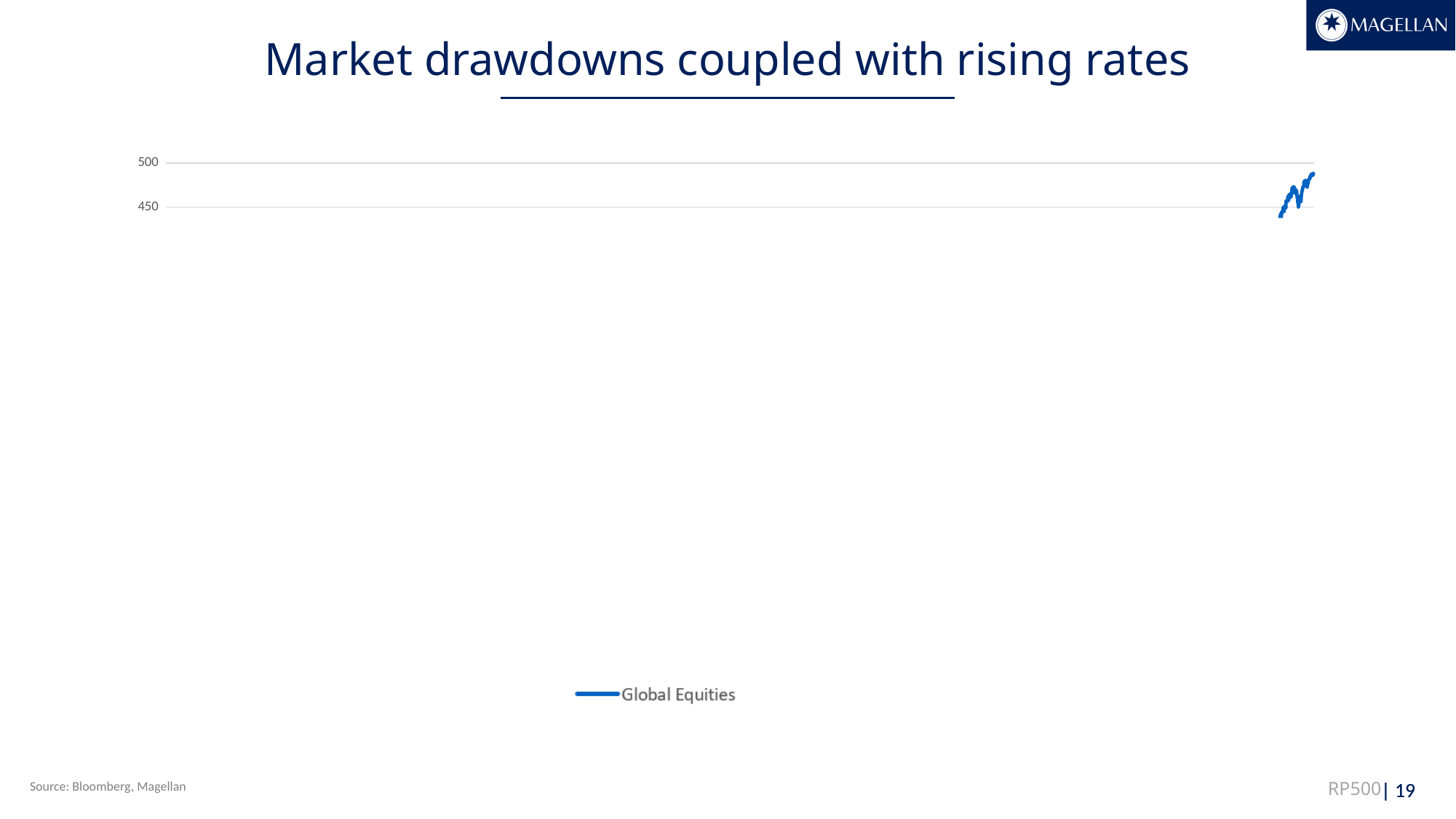
How many series does the legend list? 1 What is the name of the series shown in the legend? Global Equities Is the visible portion of the Global Equities line above or below the 500 gridline? below What is the title of the slide containing the chart? Market drawdowns coupled with rising rates Does the visible portion of the Global Equities line end above or below 450? above What kind of chart is shown on the slide? line chart